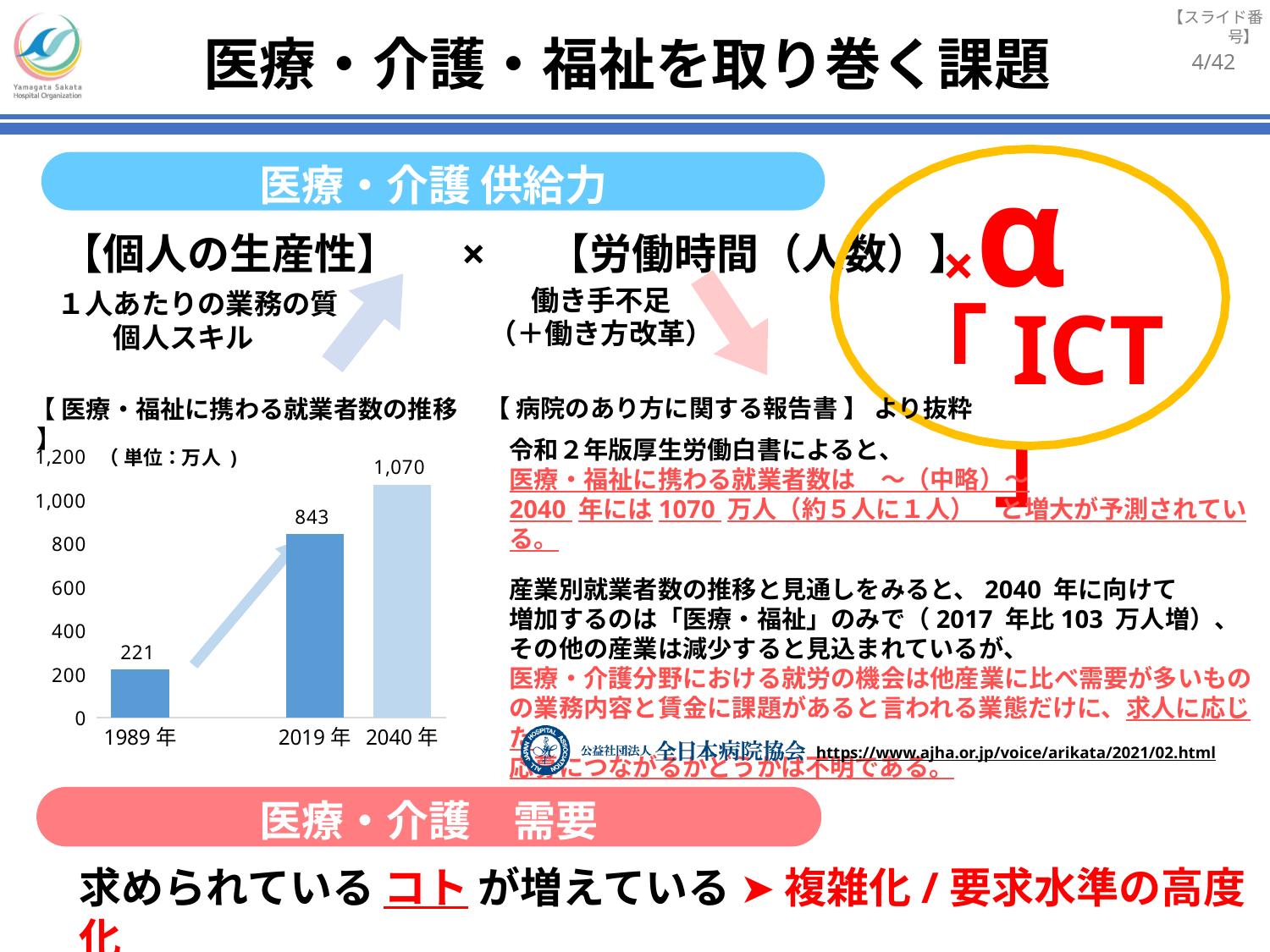
Which year has the lowest value in the bar chart? 1989年 What is the value for 2019年 in the bar chart? 843 What is the difference between the values for 2019年 and 1989年? 622 Which year has the highest value in the bar chart? 2040年 How many years (categories) are shown in the bar chart? 3 What is the value for 1989年 in the bar chart? 221 What is the value for 2040年 in the bar chart? 1,070 What unit is stated for the values in the bar chart? 万人 Is the value for 2040年 greater or less than 1,000? greater Which is larger, the value for 2019年 or the value for 1989年? 2019年 What is the difference between the values for 2040年 and 2019年? 227 What kind of chart is shown on the slide? bar chart